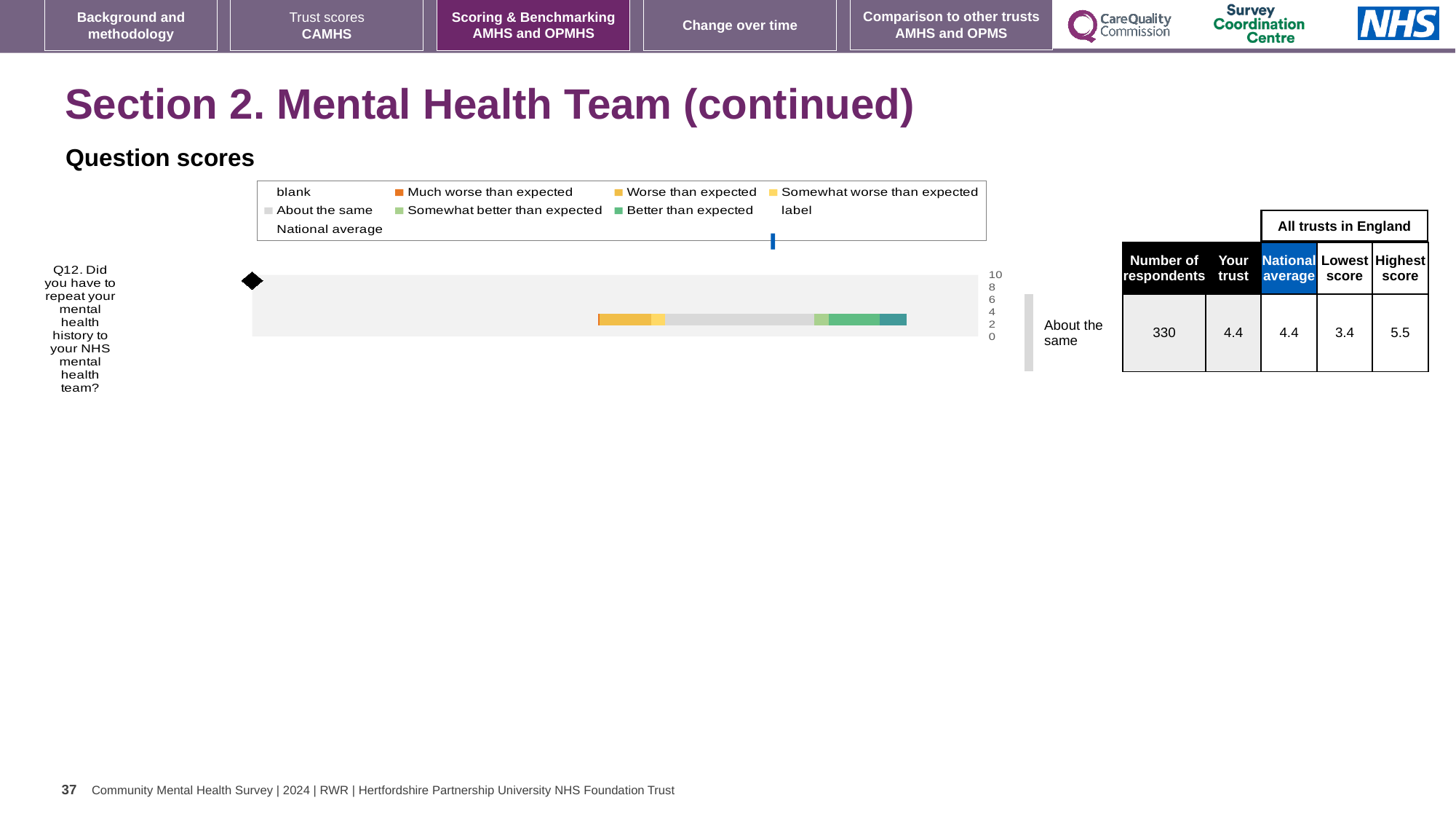
How many respondents answered Q12? 330 What is the difference between the highest score and the lowest score for Q12? 2.1 What is the lowest score among all trusts in England for Q12? 3.4 What is the national average score for Q12? 4.4 What is the maximum value shown on the chart's score axis? 10 What is the highest score among all trusts in England for Q12? 5.5 Is the 'Your trust' score for Q12 greater or less than 6? less Which benchmark category is the trust's score for Q12 placed in? About the same What is the 'Your trust' score for Q12? 4.4 Which question is plotted in the chart? Q12. Did you have to repeat your mental health history to your NHS mental health team? What kind of chart is shown under 'Question scores'? bar chart How many survey questions are plotted in the chart? 1